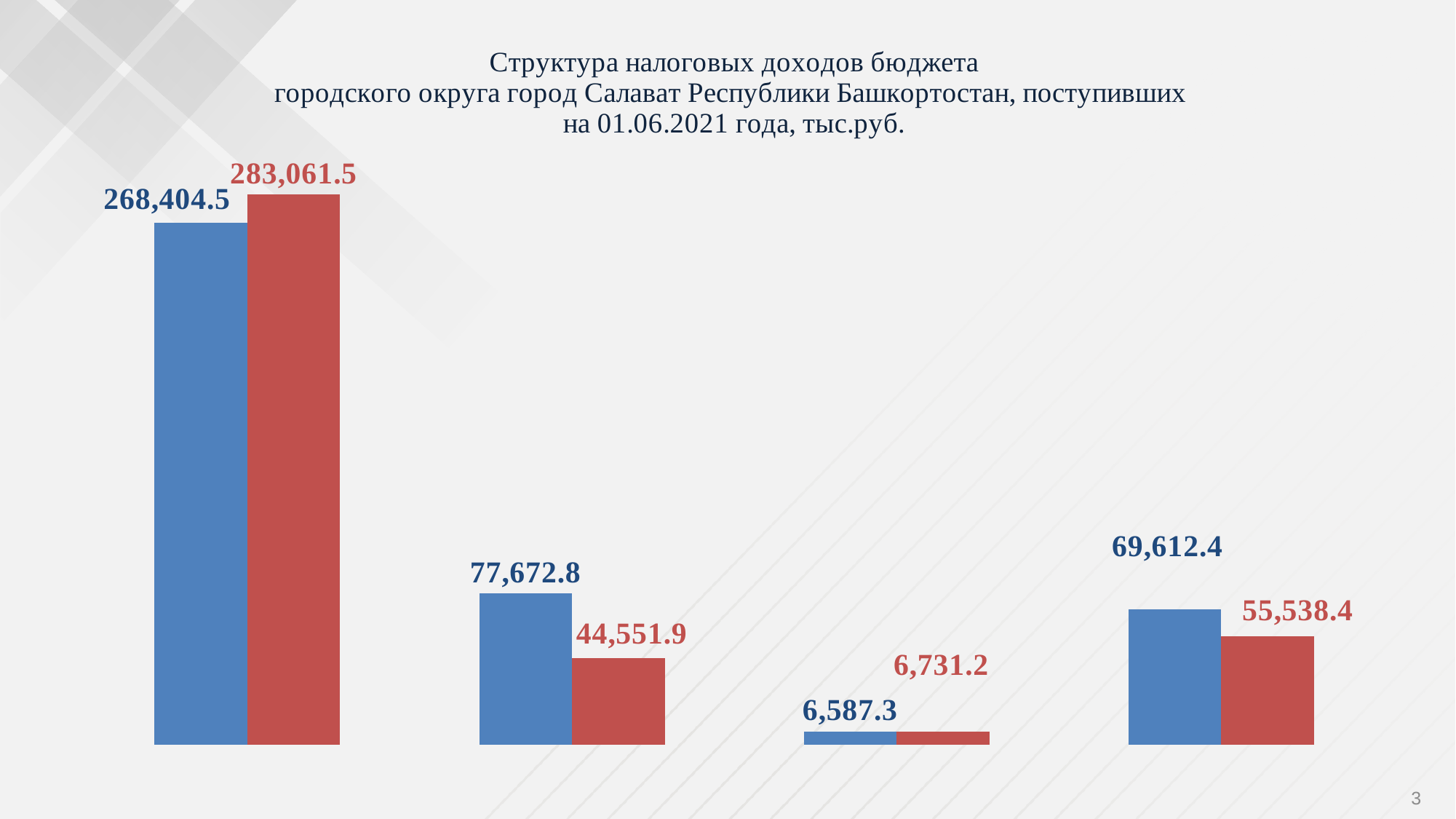
What is the value of the red bar in the leftmost group? 283,061.5 What kind of chart is shown on the slide? bar chart What is the lowest red bar value in the chart? 6,731.2 In the rightmost group, which bar is larger, the blue one or the red one? the blue one What is the value of the blue bar in the rightmost group? 69,612.4 How many groups of bars are plotted in the chart? 4 What is the value of the blue bar in the leftmost group? 268,404.5 In the leftmost group, how much larger is the red bar than the blue bar? 14,657.0 In the second group from the left, what is the difference between the blue bar (77,672.8) and the red bar (44,551.9)? 33,120.9 Which group of bars has the highest blue value? the leftmost group (268,404.5) What is the value of the red bar in the third group from the left? 6,731.2 In what units are the values in the chart expressed, according to the title? тыс.руб.